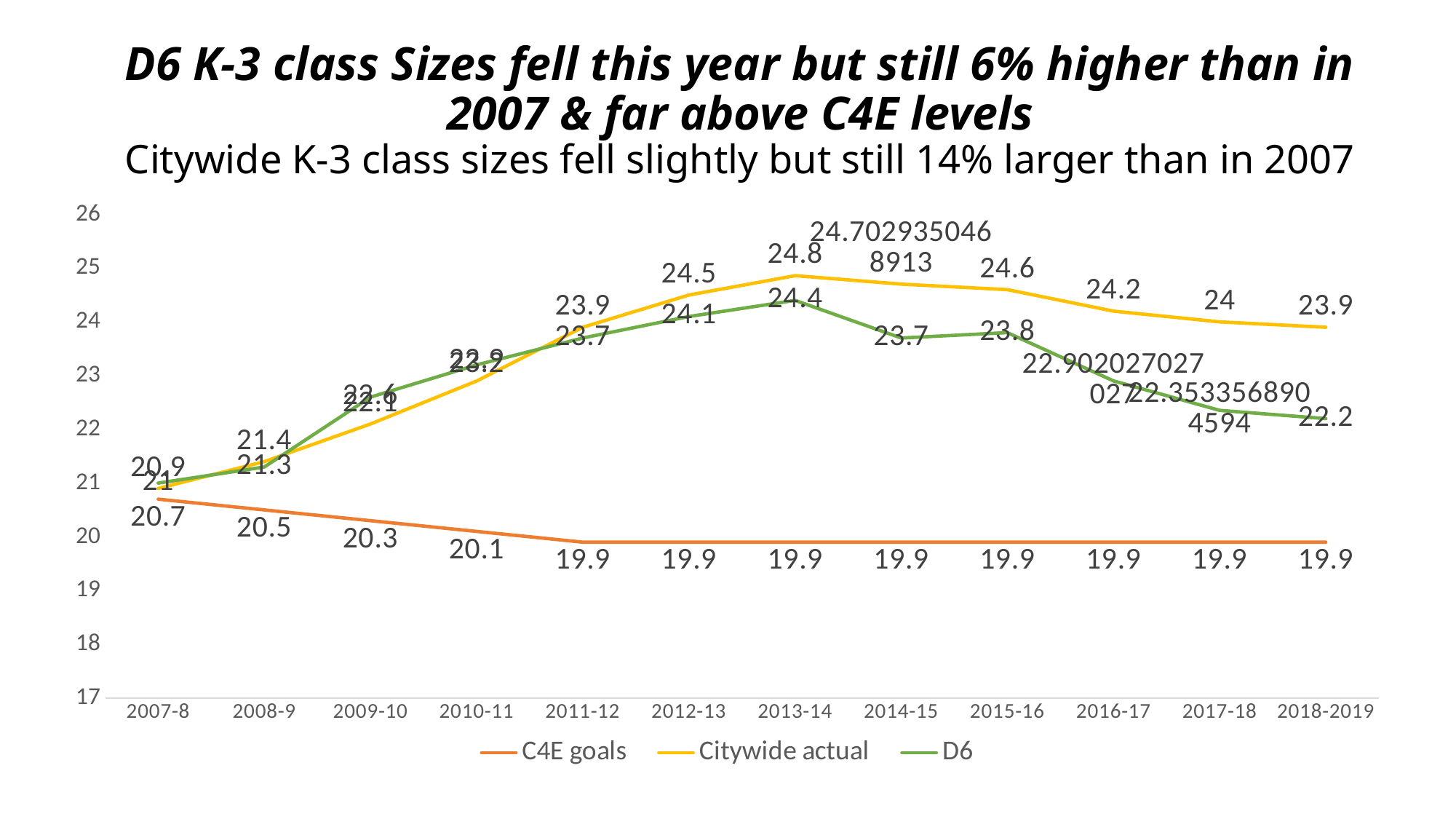
What type of chart is shown on the slide? line chart What is the D6 value for 2018-2019? 22.2 How many series does the legend list? 3 What is the Citywide actual value for 2013-14? 24.8 What is the Citywide actual value for 2017-18? 24 What is the C4E goals value for 2007-8? 20.7 Is the D6 value for 2016-17 greater or less than 23? less In which school year does the Citywide actual series reach its highest value? 2013-14 Which is larger in 2015-16, the Citywide actual value or the D6 value? Citywide actual How many school years are plotted along the x axis? 12 What is the difference between the Citywide actual and D6 values in 2018-2019? 1.7 What is the lowest value of the C4E goals series? 19.9